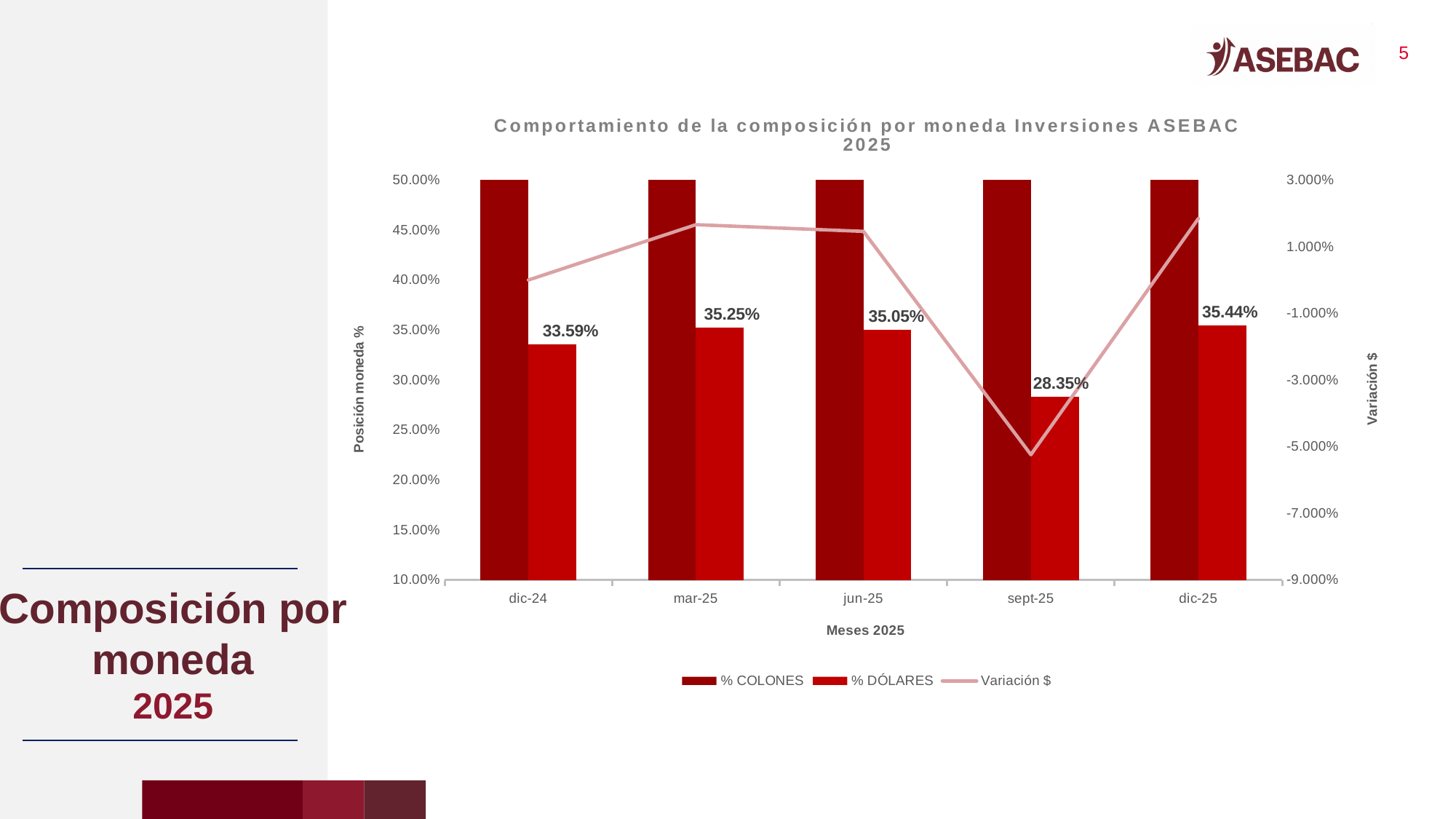
What is the difference between the % DÓLARES values for dic-25 and sept-25? 7.09 percentage points What is the % DÓLARES value for sept-25? 28.35% Which month has the highest % DÓLARES value? dic-25 What is the % DÓLARES value for dic-24? 33.59% How many months are shown on the x axis? 5 Which is larger, the % DÓLARES value for mar-25 or for jun-25? mar-25 Which month has the lowest % DÓLARES value? sept-25 Is the Variación $ value for mar-25 greater or less than 1.000%? greater What kind of chart is shown on the slide? Combined bar and line chart How many series does the legend list? 3 What is the % DÓLARES value for dic-25? 35.44% Is the Variación $ value for sept-25 greater or less than -3.000%? less